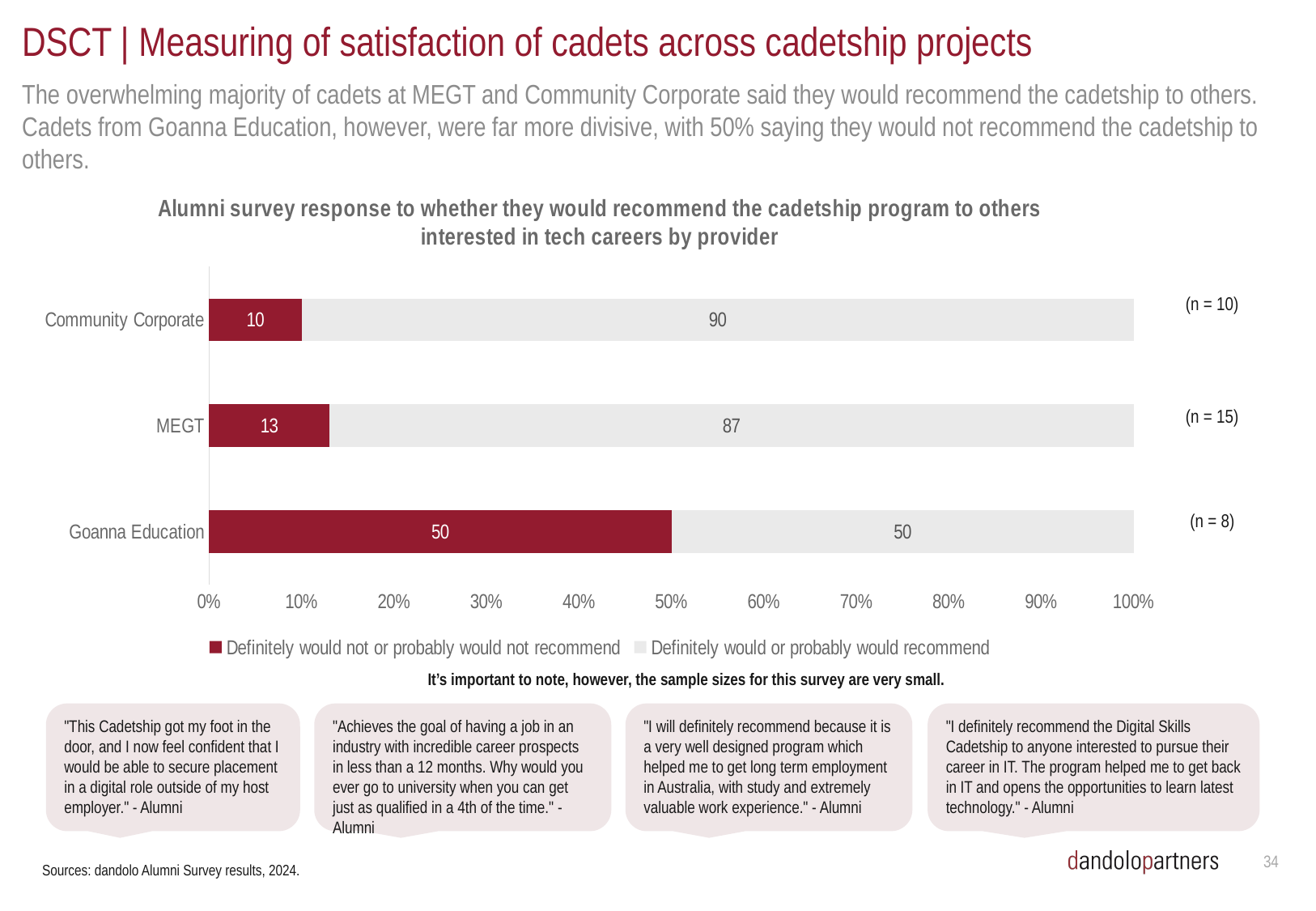
How many series does the legend list? 2 What percentage of MEGT cadets said they definitely would not or probably would not recommend the cadetship? 13 How many providers are shown in the chart? 3 Which provider has a larger share of cadets who would recommend the cadetship, MEGT or Goanna Education? MEGT What is the sample size (n) shown for Goanna Education? n = 8 What is the difference between the 'would recommend' percentages for Community Corporate and MEGT? 3 What is the total of the two segments in the MEGT bar? 100 Which provider has the highest share of cadets who would not recommend the cadetship? Goanna Education What percentage of Goanna Education cadets said they definitely would or probably would recommend the cadetship? 50 What kind of chart is shown on the slide? Stacked bar chart What percentage of Community Corporate cadets said they definitely would or probably would recommend the cadetship? 90 Which provider has the lowest share of cadets who would not recommend the cadetship? Community Corporate